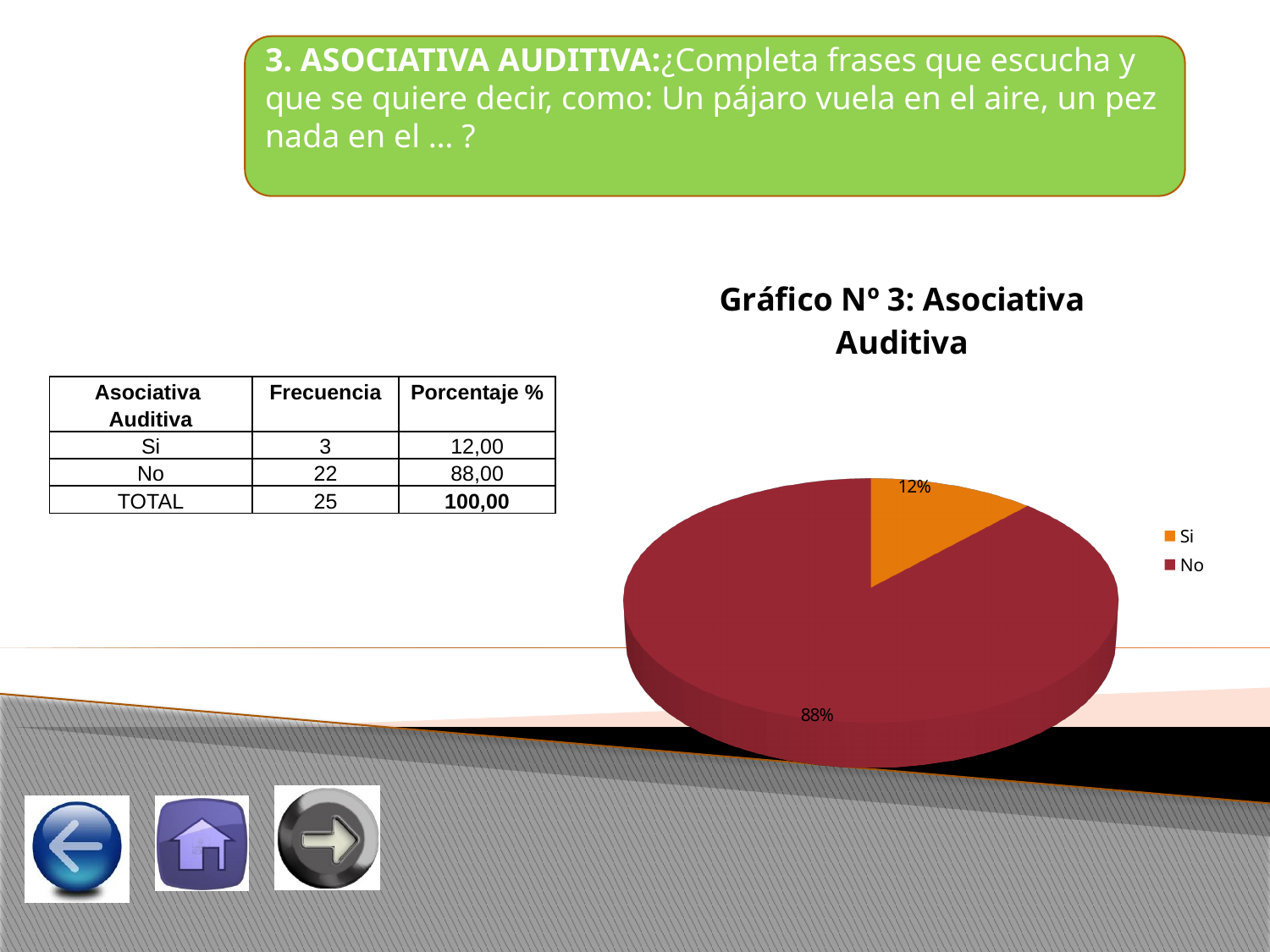
Which category has the smallest slice in the pie chart? Si What share of the pie does the 'No' slice represent? 88% What is the title of the chart? Gráfico Nº 3: Asociativa Auditiva What percentage does the 'Si' slice show in the pie chart? 12% Which category has the largest slice in the pie chart? No What percentage does the 'No' slice show in the pie chart? 88% How many entries does the legend list? 2 Which slice is larger, 'Si' or 'No'? No What is the difference in percentage points between the 'No' slice and the 'Si' slice? 76 What kind of chart is shown on the slide? pie chart How many slices does the pie chart have? 2 What colour is the 'Si' slice in the pie chart? orange